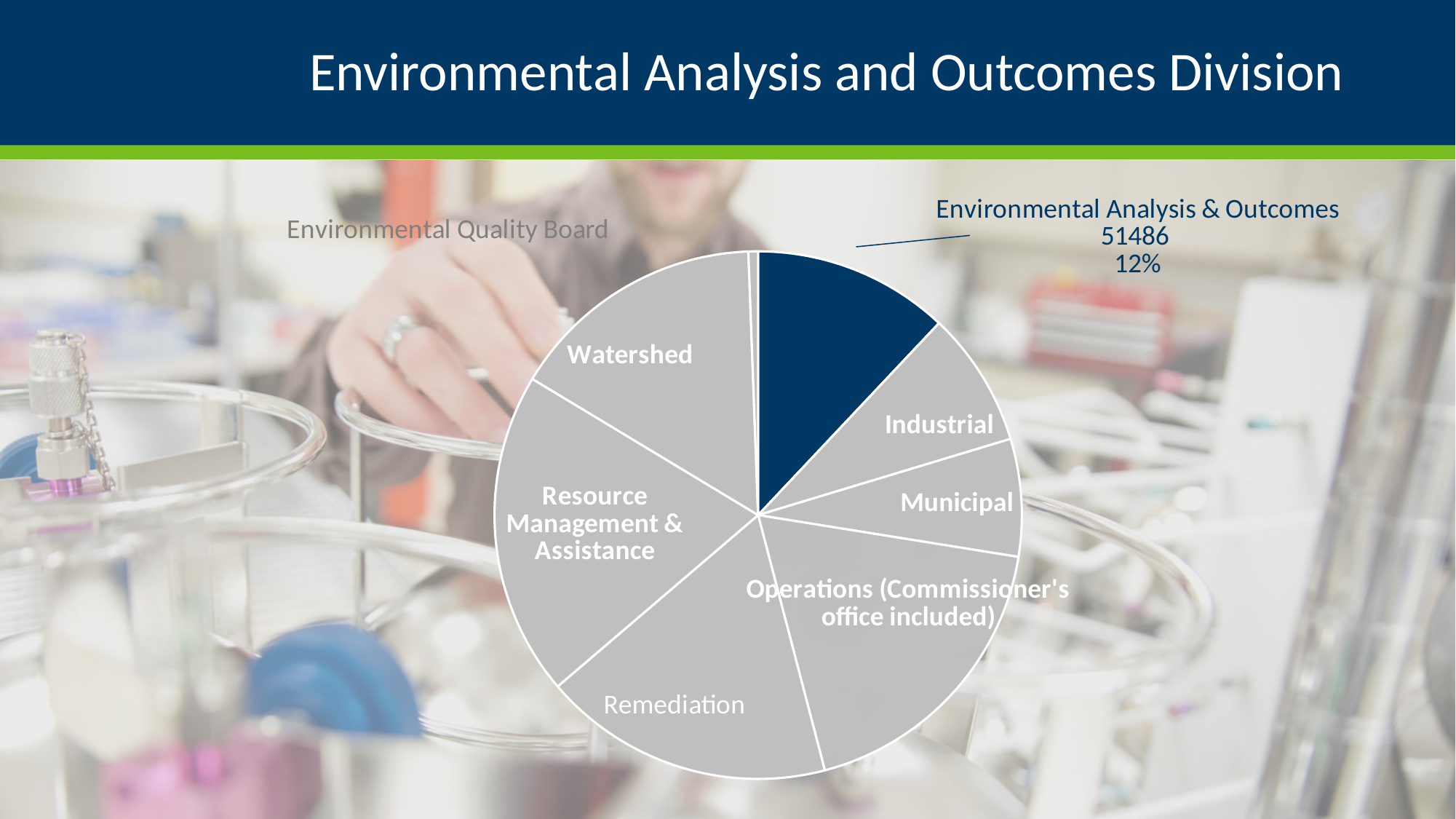
Which slice is larger, Watershed or Environmental Quality Board? Watershed Which slice is larger, Operations (Commissioner's office included) or Municipal? Operations (Commissioner's office included) Which slice of the pie chart is highlighted in dark blue? Environmental Analysis & Outcomes What is the title of the slide containing the pie chart? Environmental Analysis and Outcomes Division What share of the pie does the Environmental Analysis & Outcomes slice represent? 12% Which slice is larger, Resource Management & Assistance or Industrial? Resource Management & Assistance What value is shown for the Environmental Analysis & Outcomes slice? 51486 How many slices does the pie chart have? 8 What kind of chart is shown on the slide? pie chart Which slice of the pie chart is the smallest? Environmental Quality Board